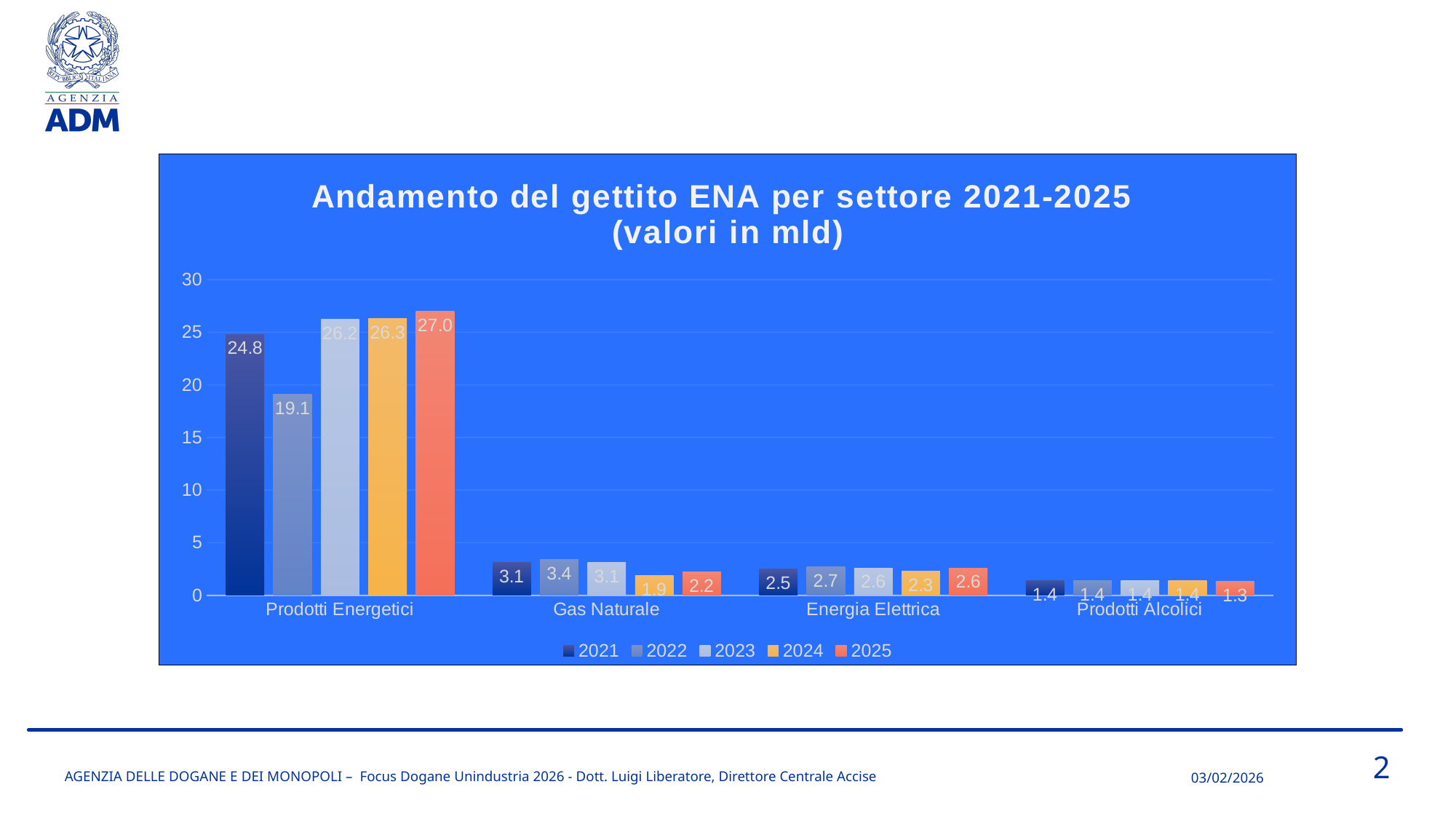
What is the value for Energia Elettrica in 2024? 2.3 What is the title of the chart? Andamento del gettito ENA per settore 2021-2025 (valori in mld) What is the value for Prodotti Energetici in 2025? 27.0 What is the value for Gas Naturale in 2022? 3.4 How many series does the legend list? 5 Which is larger for Gas Naturale: the 2021 value or the 2025 value? 2021 What kind of chart is shown on the slide? Bar chart What is the value for Prodotti Alcolici in 2025? 1.3 Which year has the lowest value for Prodotti Energetici? 2022 What is the difference between the 2025 and 2021 values for Prodotti Energetici? 2.2 Which year has the highest value for Prodotti Energetici? 2025 How many categories are shown on the x axis? 4